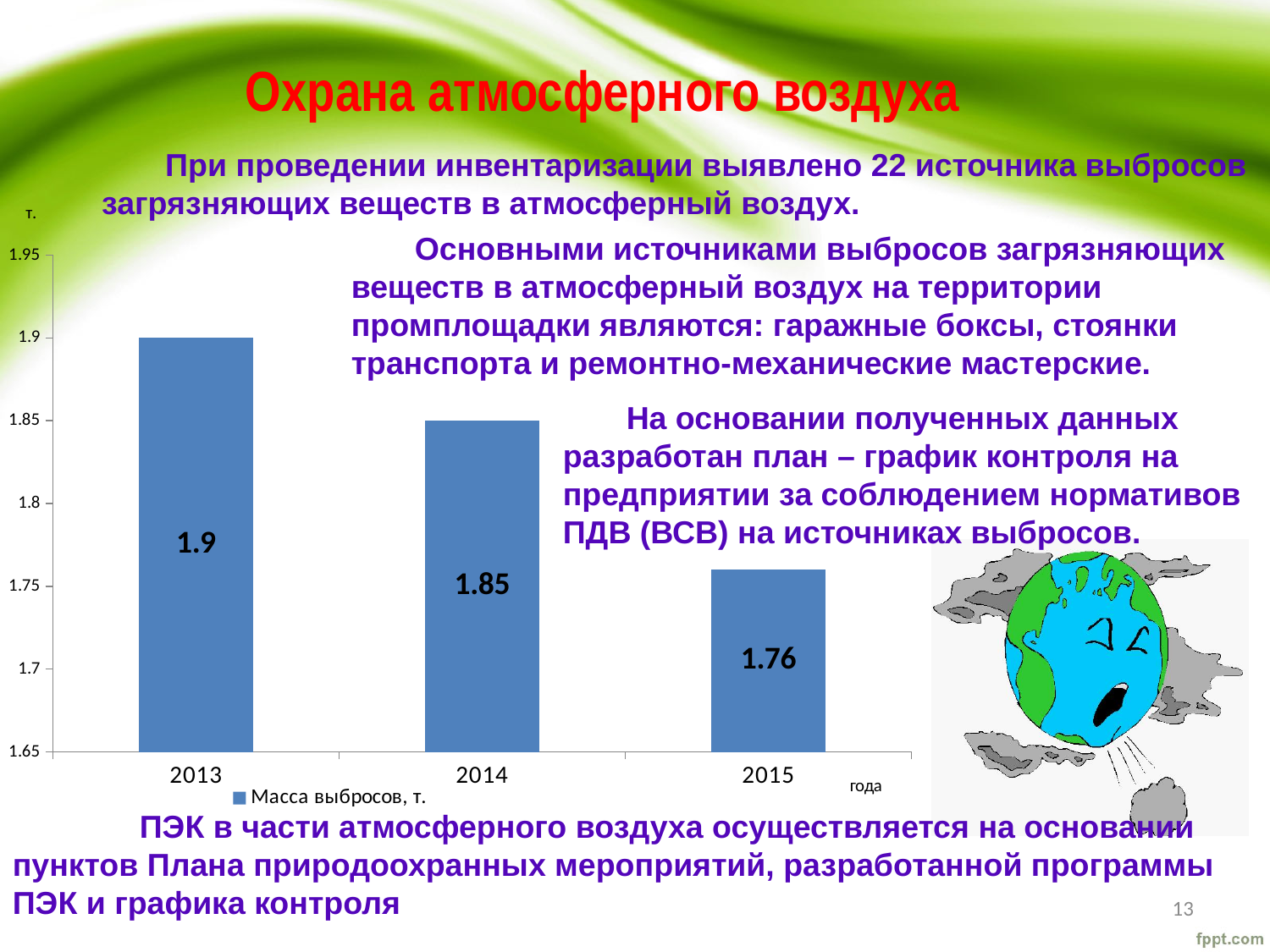
Which year has the lowest mass of emissions? 2015 How many series does the legend list? 1 What is the difference between the emissions in 2013 and 2015? 0.14 What kind of chart is shown on the slide? bar chart How many years are shown on the chart? 3 What was the mass of emissions in 2014? 1.85 Do the emission values rise or fall from 2013 to 2015? fall Which year had larger emissions, 2014 or 2015? 2014 What is the difference between the emissions in 2014 and 2015? 0.09 What was the mass of emissions in 2013? 1.9 Which year has the highest mass of emissions? 2013 What was the mass of emissions in 2015? 1.76